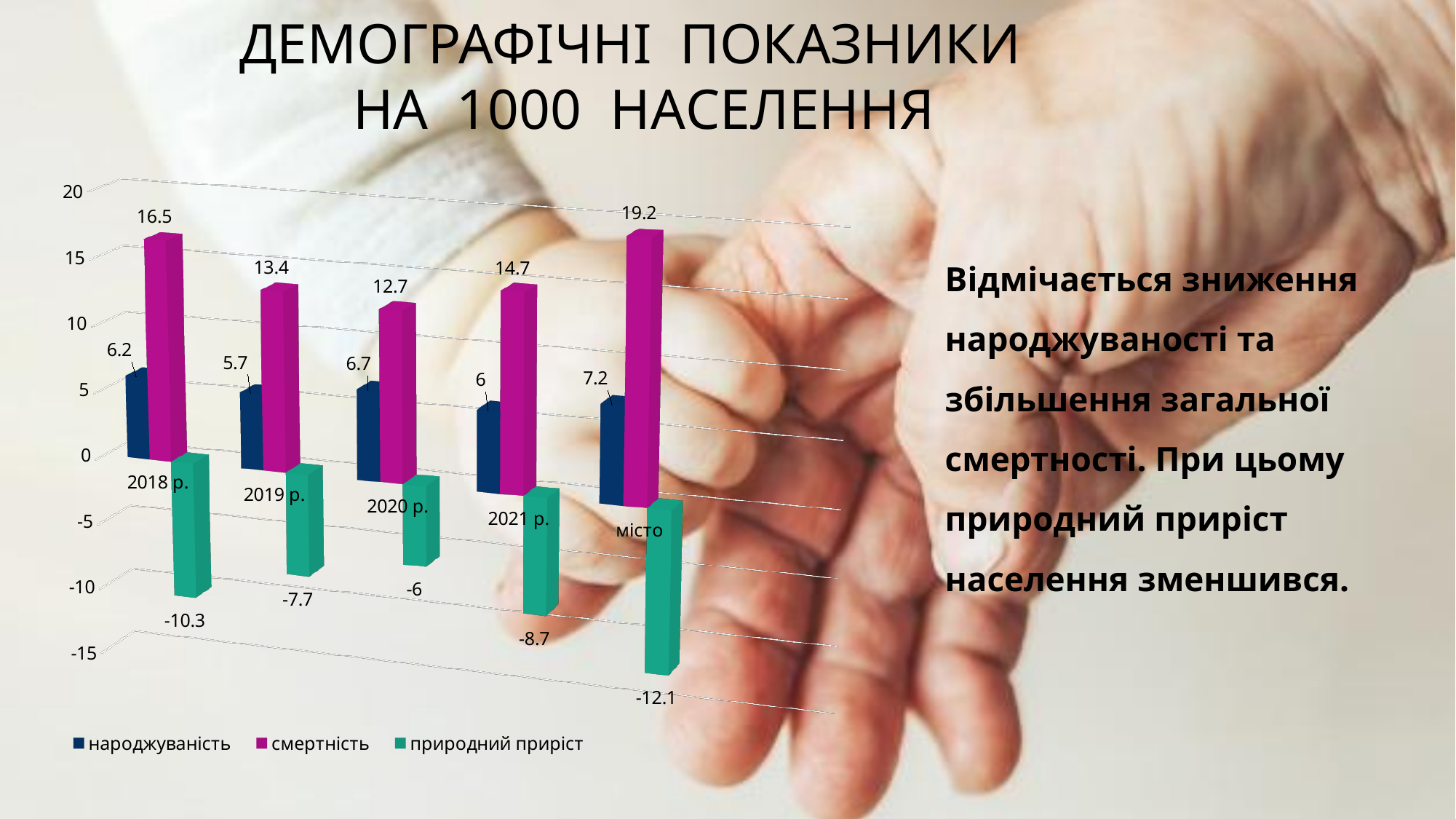
How many series does the legend list? 3 Which series is shown in magenta in the legend? смертність What is the value of смертність for 2018 р.? 16.5 How many categories are shown on the x axis? 5 Which category has the lowest народжуваність value? 2019 р. What is the difference between смертність and народжуваність for 2019 р.? 7.7 What kind of chart is shown on the slide? bar chart What is the value of народжуваність for 2020 р.? 6.7 What is the value of народжуваність for 2021 р.? 6 Which is larger: смертність for 2020 р. or смертність for 2021 р.? смертність for 2021 р. What is the value of природний приріст for місто? -12.1 Which category has the highest смертність value? місто